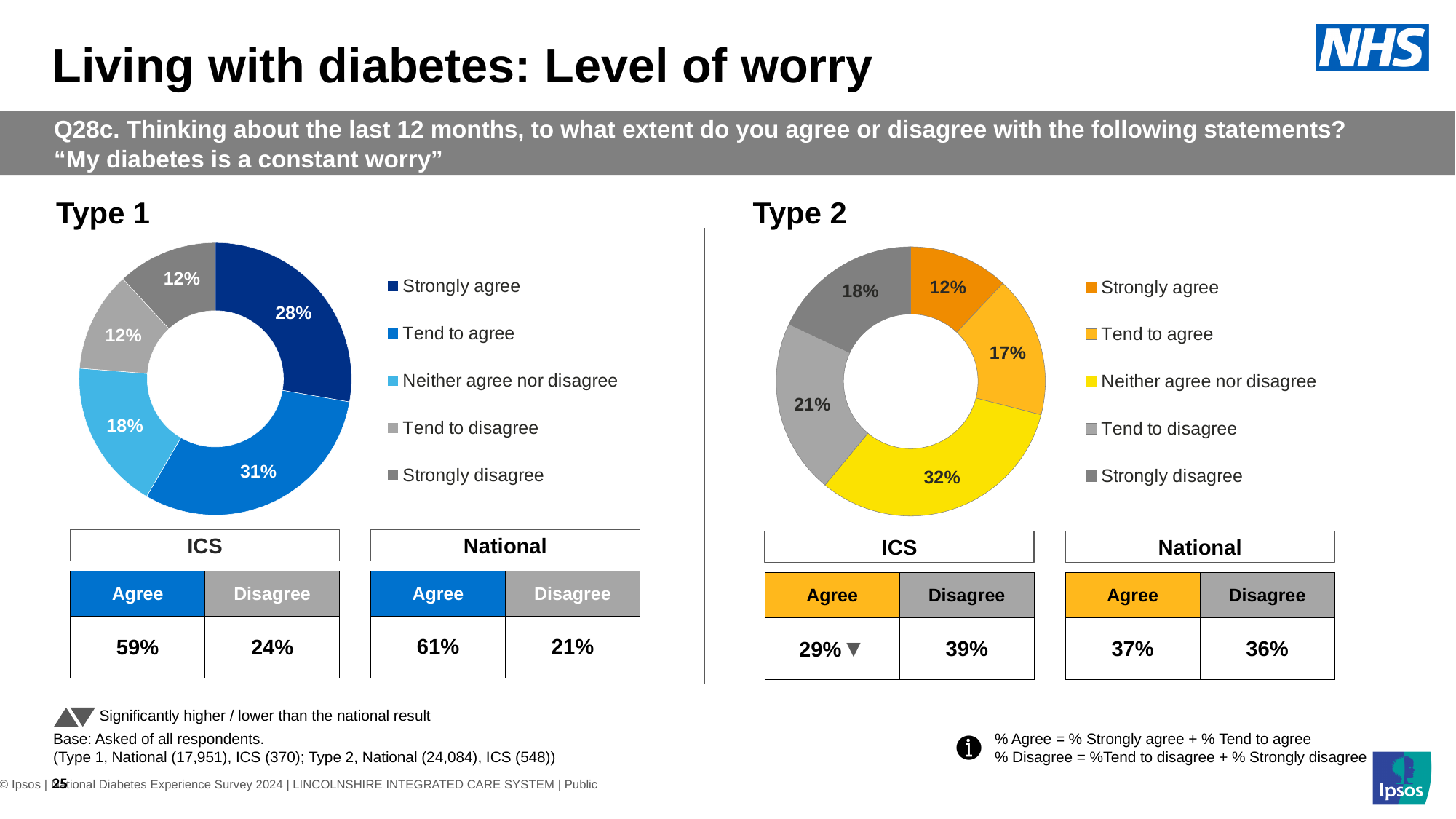
In the Type 1 chart, what percentage of respondents said they strongly agree? 28% In the Type 2 chart, which response category has the smallest share? Strongly agree In the Type 2 chart, what colour represents Neither agree nor disagree? Yellow In the Type 2 chart, which is larger: the Strongly disagree share or the Tend to agree share? Strongly disagree In the Type 1 chart, what percentage of respondents said they tend to agree? 31% In the Type 2 chart, what percentage of respondents said they tend to disagree? 21% In the Type 2 chart, which response category has the largest share? Neither agree nor disagree What kind of chart is used to show the Type 2 results? Donut (pie) chart In the Type 1 chart, which response category has the largest share? Tend to agree In the Type 2 chart, what percentage of respondents said they neither agree nor disagree? 32% How many response categories does the legend of the Type 1 chart list? 5 In the Type 1 chart, what is the difference between the Tend to agree and Strongly agree shares? 3 percentage points